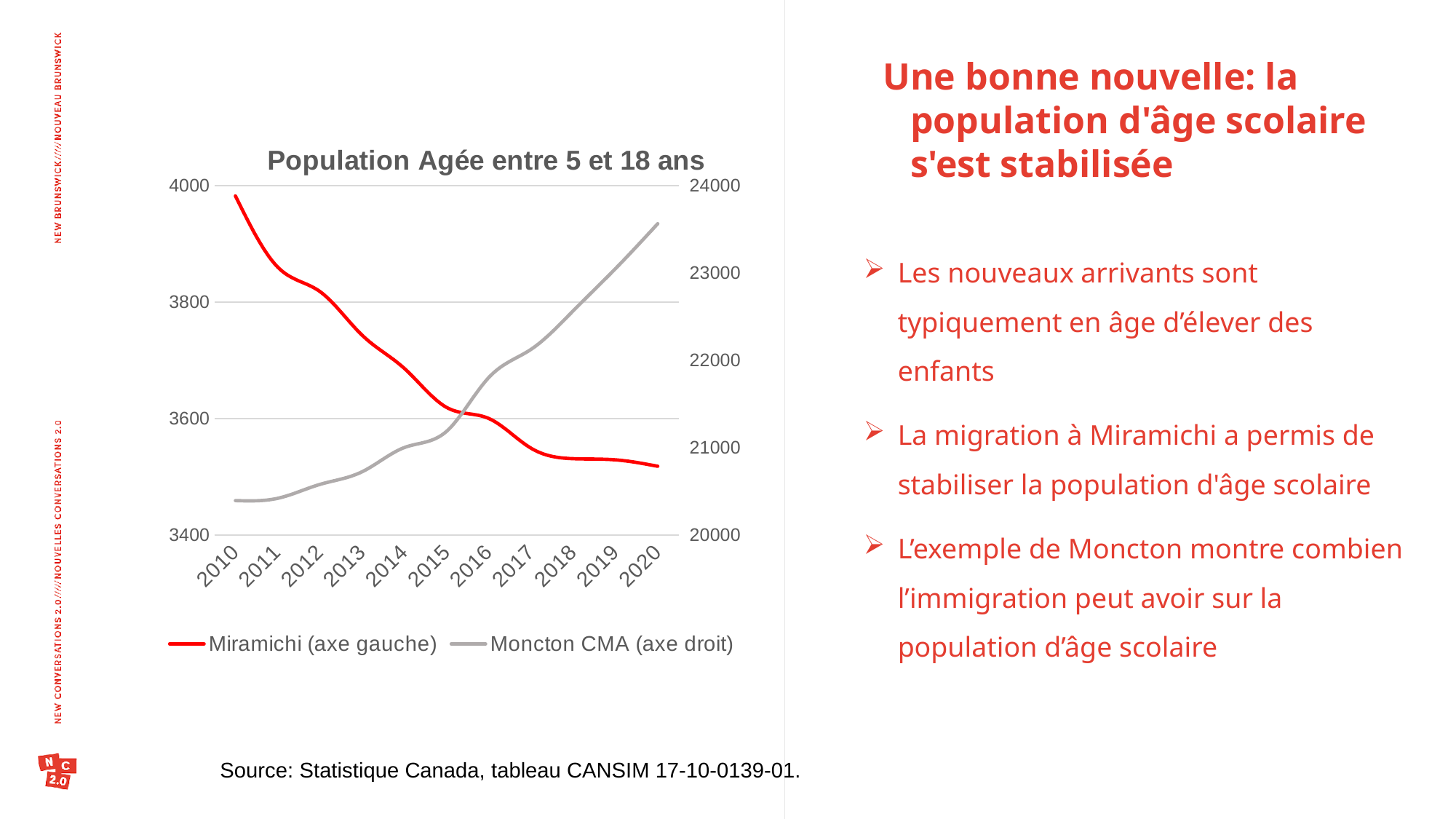
Does the Moncton CMA series rise or fall from 2010 to 2020? rise Does the Miramichi series rise or fall from 2010 to 2020? fall How many years are plotted along the x axis? 11 Is the Miramichi value for 2020 greater or less than 3600? less In which year is the Miramichi value highest? 2010 Which series is plotted against the right axis? Moncton CMA (axe droit) Is the Moncton CMA value for 2020 greater or less than 23000? greater What is the title of the chart? Population Agée entre 5 et 18 ans In which year is the Moncton CMA value highest? 2020 How many series does the legend list? 2 What kind of chart is shown on the slide? line chart In which year is the Miramichi value lowest? 2020